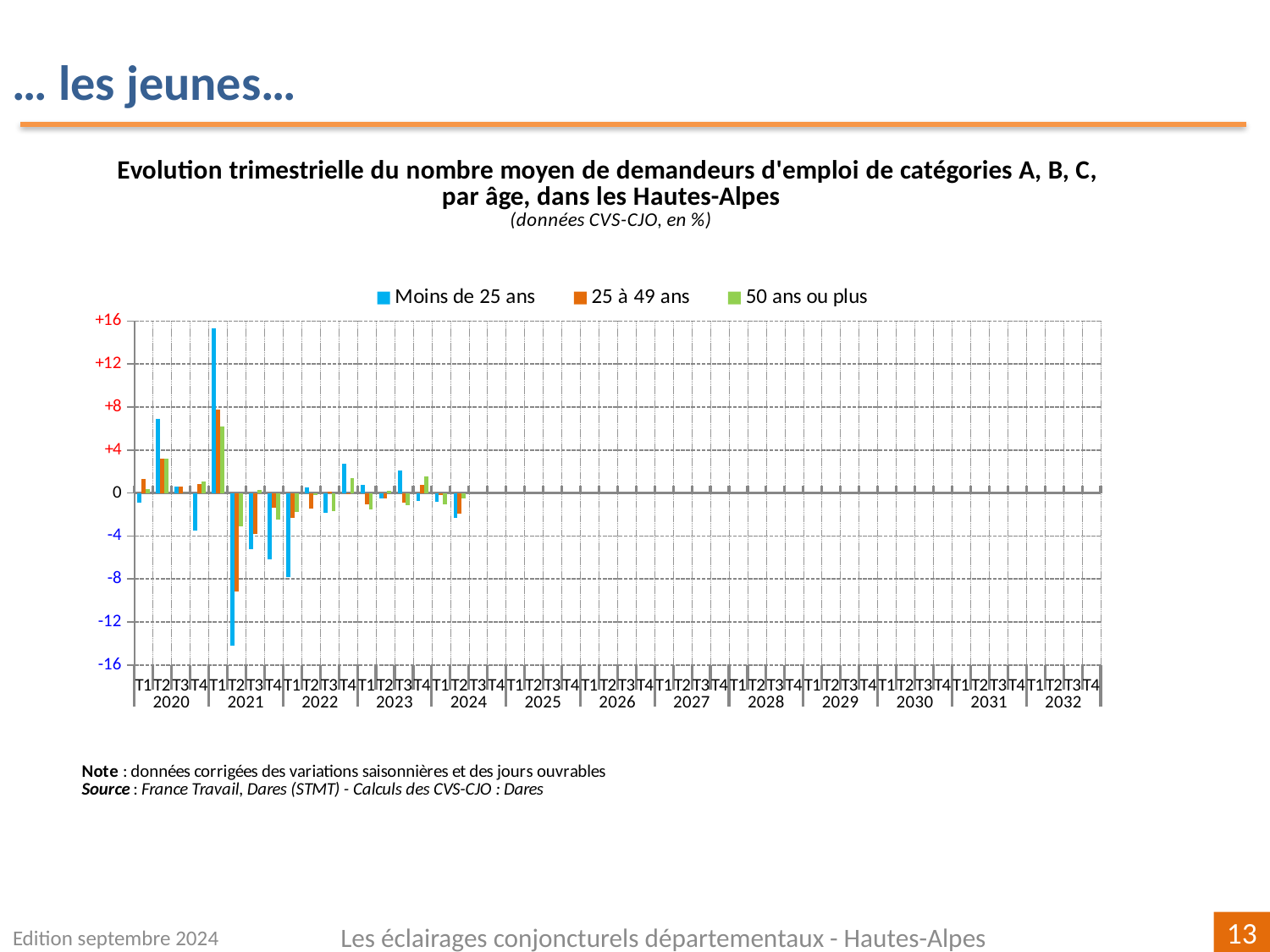
Is the value for '25 à 49 ans' in T2 2021 greater or less than -4? less In T1 2021, which series has the larger value: 'Moins de 25 ans' or '25 à 49 ans'? Moins de 25 ans Is the value for 'Moins de 25 ans' in T2 2021 greater or less than -12? less In which quarter does the 'Moins de 25 ans' series reach its lowest value? T2 2021 Is the value for 'Moins de 25 ans' in T2 2020 greater or less than +4? greater In which quarter does the 'Moins de 25 ans' series reach its highest value? T1 2021 Which series is shown in orange in the legend? 25 à 49 ans How many years are labelled along the x axis? 13 Which series is shown in blue in the legend? Moins de 25 ans What kind of chart is shown on the slide? bar chart How many series does the legend list? 3